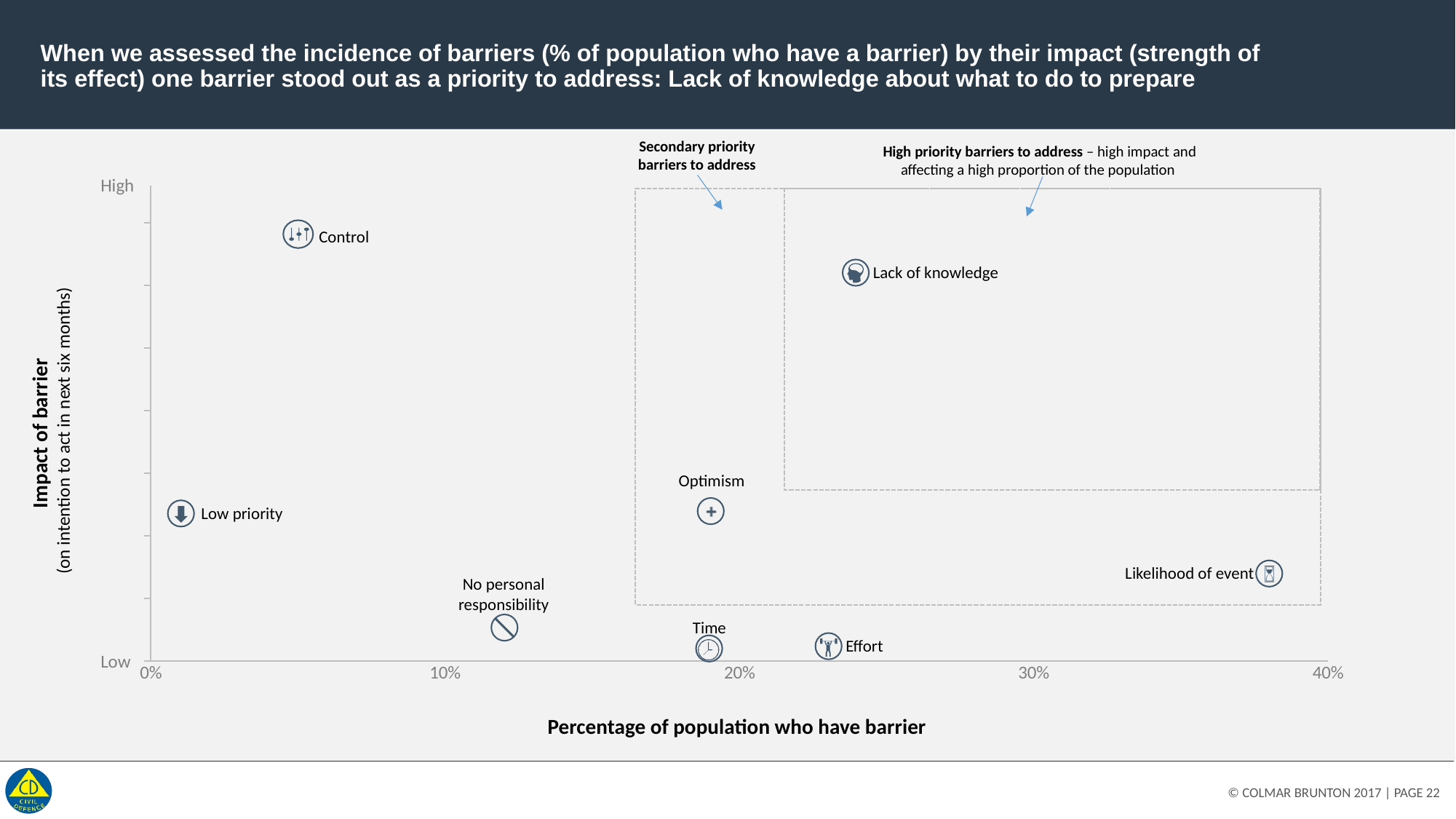
Which barrier has the lowest percentage of population who have it? Low priority Is the percentage of population for Lack of knowledge greater or less than 20%? greater What is the title of the horizontal axis? Percentage of population who have barrier Is the percentage of population for No personal responsibility greater or less than 20%? less Is the percentage of population for Likelihood of event greater or less than 30%? greater Which barrier affects a larger percentage of the population, Lack of knowledge or Control? Lack of knowledge What kind of chart is shown on the slide? Scatter chart Which barrier has the highest impact on intention to act? Control Which barrier has a higher impact, Control or Optimism? Control How many barriers are plotted on the chart? 8 Which barrier has the highest percentage of population who have it? Likelihood of event